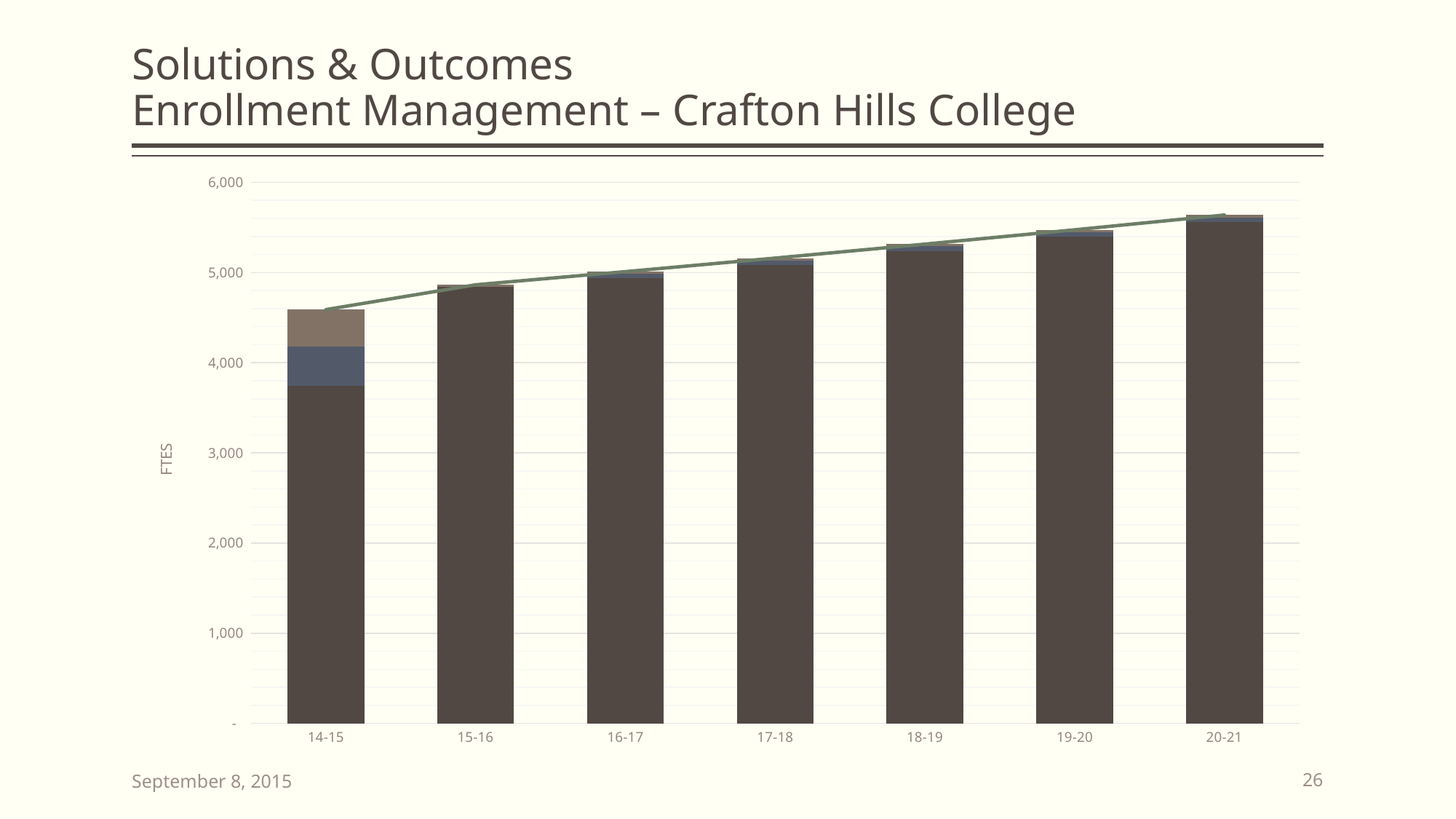
Which bar is taller, 14-15 or 20-21? 20-21 Is the total bar height for 14-15 greater or less than 4,000? greater Which academic year has the tallest bar in the chart? 20-21 Do the bar totals rise or fall from 14-15 to 20-21? Rise Is the total bar height for 15-16 greater or less than 5,000? less What kind of chart is shown on the slide? Combination bar and line chart Is the total bar height for 18-19 greater or less than 5,000? greater What is the highest value shown on the vertical axis of the chart? 6,000 Which academic year has the shortest bar in the chart? 14-15 What is the label on the vertical axis of the chart? FTES How many academic years are shown on the x axis of the chart? 7